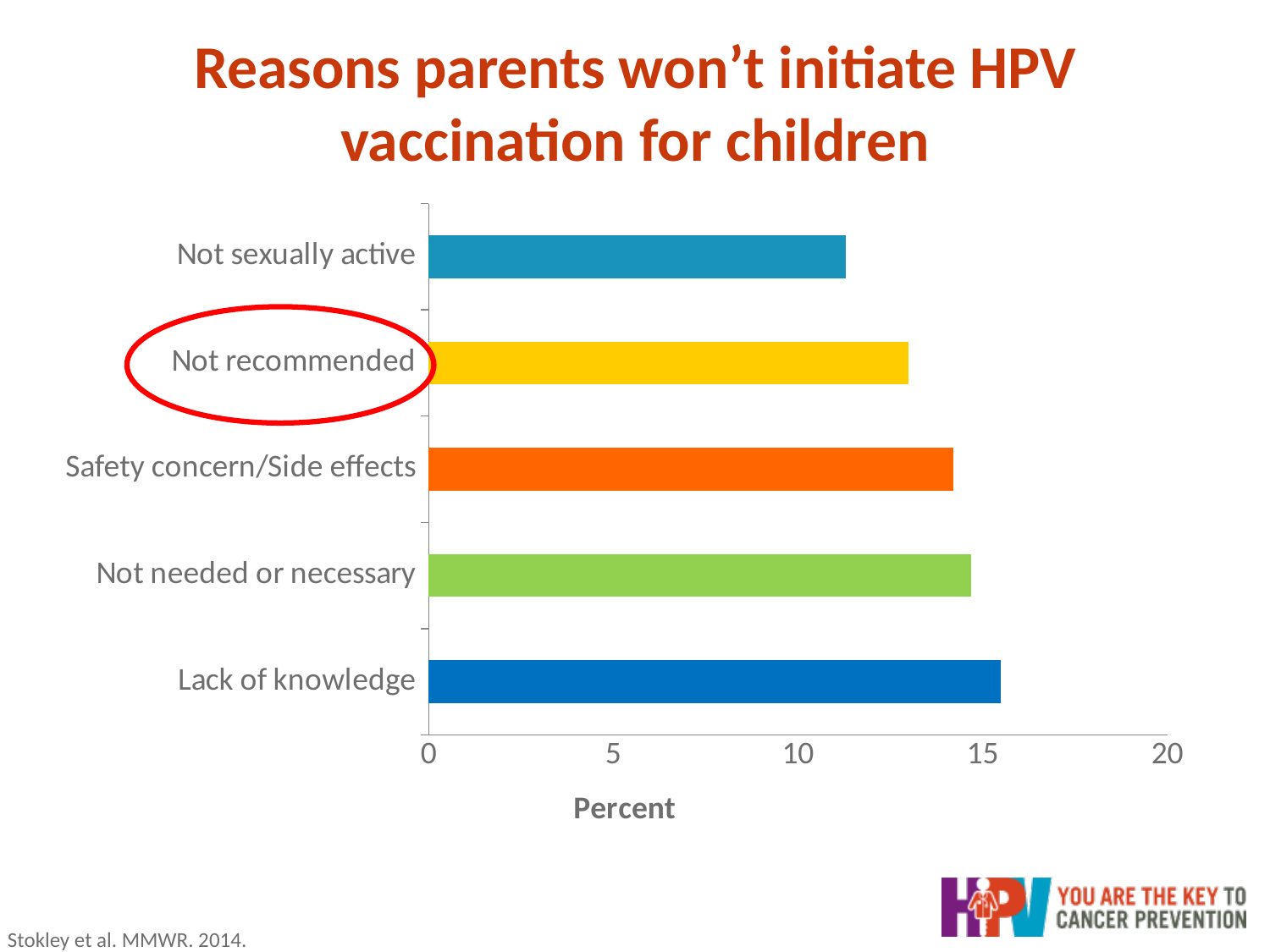
How many reasons (categories) are plotted in the chart? 5 Which reason has the highest percentage? Lack of knowledge Which reason has the lowest percentage? Not sexually active Is the value for Not sexually active greater or less than 10? greater Which is larger, the value for Not sexually active or the value for Safety concern/Side effects? Safety concern/Side effects Which category label is circled in red on the chart? Not recommended Is the value for Safety concern/Side effects greater or less than 10? greater What kind of chart is shown on the slide? bar chart Which is larger, the value for Lack of knowledge or the value for Not recommended? Lack of knowledge Is the value for Lack of knowledge greater or less than 15? greater What is the label on the horizontal axis of the chart? Percent